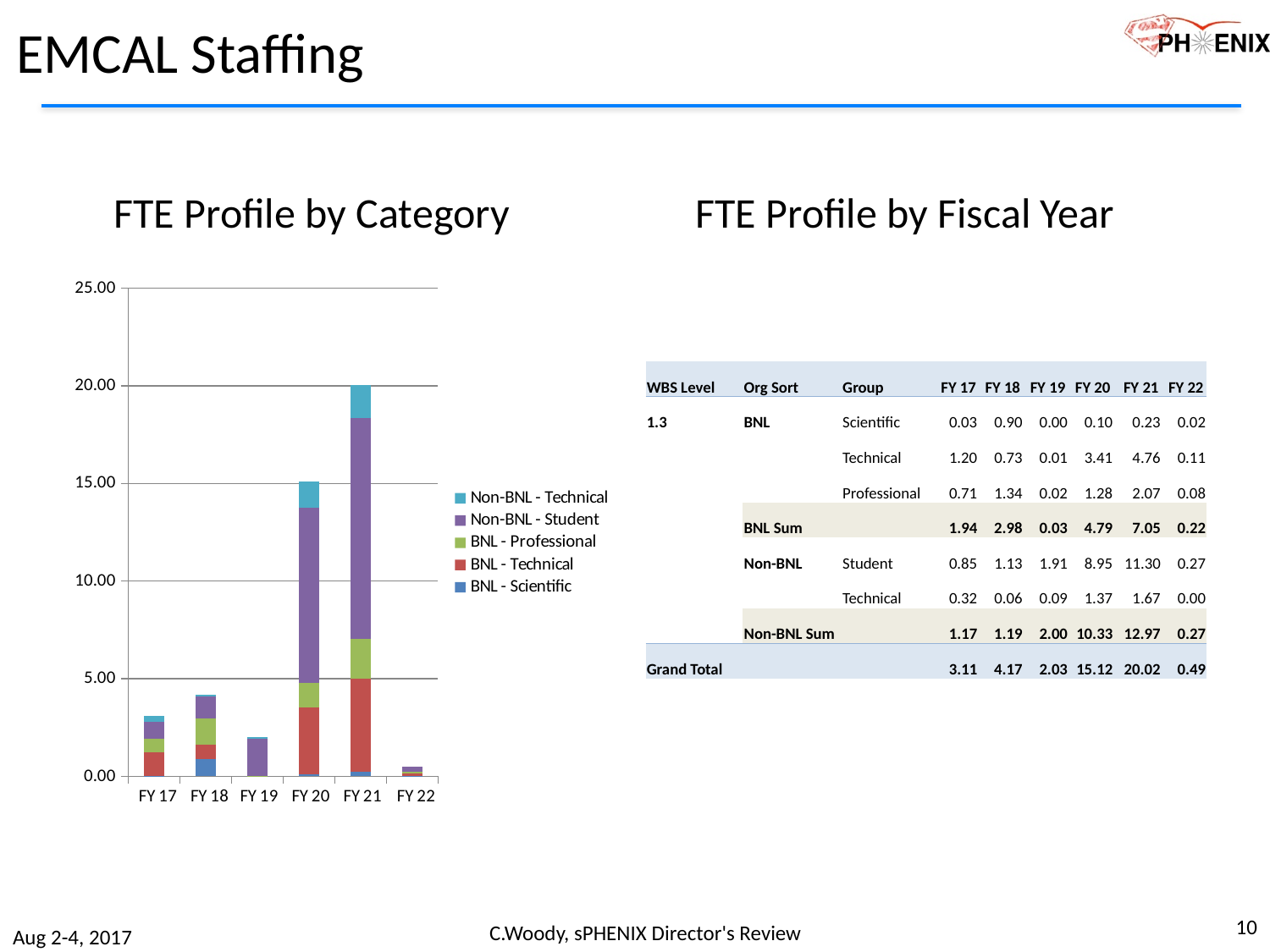
In the FTE Profile by Category chart, is the total bar for FY 17 greater or less than 5.00? less In the FTE Profile by Category chart, do the total bar heights rise steadily from FY 17 to FY 22? No Which legend entry is listed first (at the top) in the FTE Profile by Category chart? Non-BNL - Technical How many series does the legend of the FTE Profile by Category chart list? 5 What kind of chart is the FTE Profile by Category chart? Stacked bar chart In the FTE Profile by Category chart, which has the larger total bar, FY 20 or FY 21? FY 21 In the FTE Profile by Category chart, is the total bar for FY 20 greater or less than 10.00? greater In the FTE Profile by Category chart, which fiscal year has the shortest stacked bar? FY 22 In the FTE Profile by Category chart, which fiscal year has the tallest stacked bar? FY 21 In the FTE Profile by Category chart, which has the larger total bar, FY 19 or FY 22? FY 19 How many fiscal years are shown on the x axis of the FTE Profile by Category chart? 6 In the FTE Profile by Category chart, is the total bar for FY 21 greater or less than 15.00? greater